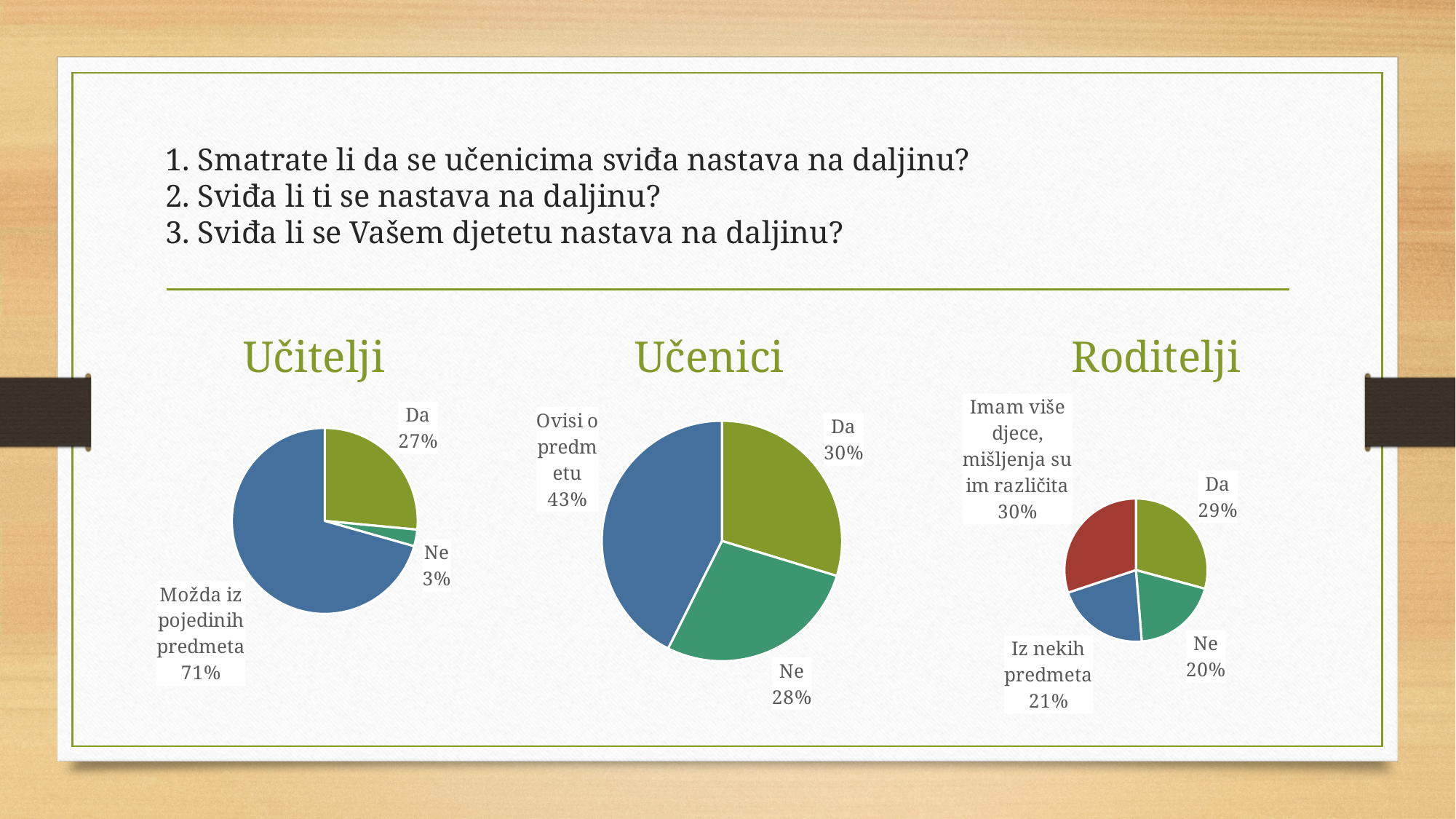
How many slices does the Učenici pie chart have? 3 In the Učenici pie chart, what percentage is shown for "Ovisi o predmetu"? 43% In the Učitelji pie chart, what percentage is shown for "Da"? 27% In the Roditelji pie chart, what percentage is shown for "Imam više djece, mišljenja su im različita"? 30% What type of chart is used for the Učitelji, Učenici and Roditelji data? Pie chart In the Učitelji pie chart, what percentage is shown for "Možda iz pojedinih predmeta"? 71% In the Učenici pie chart, what is the difference between "Ovisi o predmetu" and "Ne"? 15% In the Učitelji pie chart, what is the difference between the "Da" and "Ne" shares? 24% In the Učenici pie chart, which category has the largest share? Ovisi o predmetu In the Učitelji pie chart, which category has the smallest share? Ne In the Roditelji pie chart, what percentage is shown for "Ne"? 20% How many slices does the Roditelji pie chart have? 4